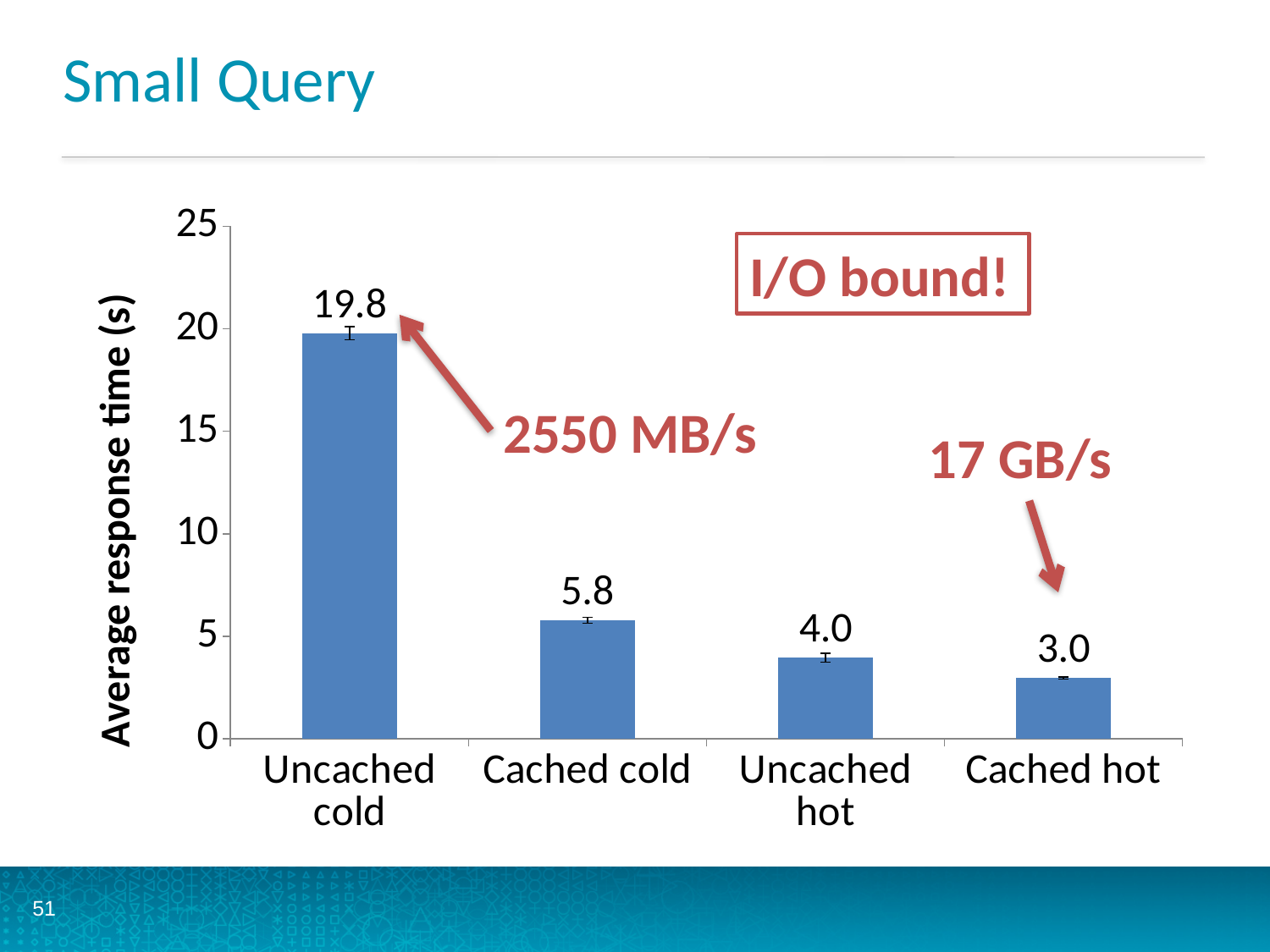
Which category has the highest average response time? Uncached cold Which has a larger average response time, Cached cold or Uncached hot? Cached cold What is the average response time for Cached cold? 5.8 Which category has the lowest average response time? Cached hot What is the label of the y axis? Average response time (s) What is the difference in average response time between Uncached cold and Cached cold? 14.0 What is the average response time for Cached hot? 3.0 What is the difference in average response time between Uncached hot and Cached hot? 1.0 What is the average response time for Uncached hot? 4.0 How many categories are shown on the x axis? 4 What is the average response time for Uncached cold? 19.8 What kind of chart is shown on the slide? Bar chart